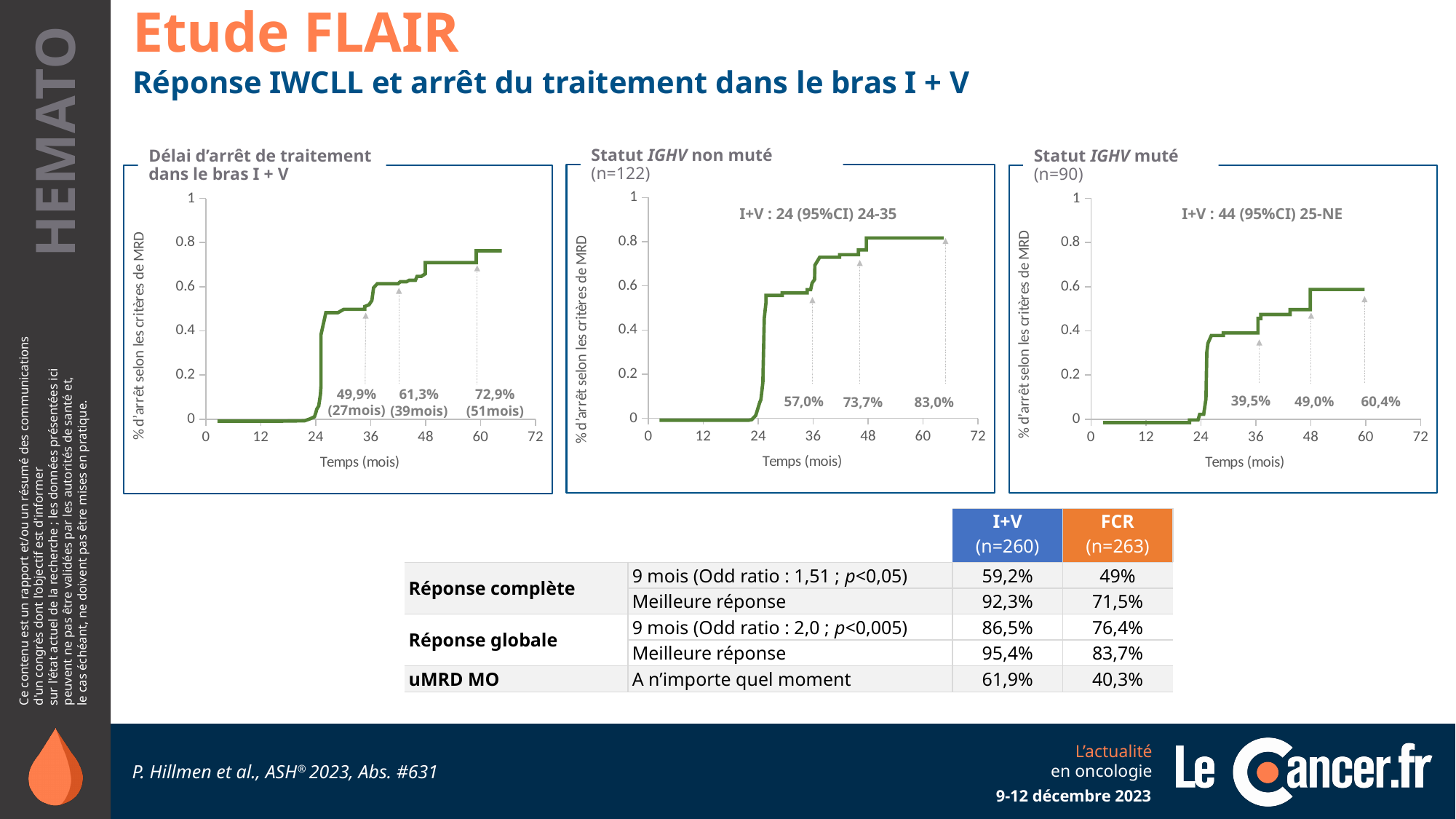
In the chart 'Délai d'arrêt de traitement dans le bras I + V', what is the difference between the values at 39 months and 27 months? 11,4% In the chart 'Statut IGHV non muté', what is the highest labelled percentage? 83,0% In the chart 'Statut IGHV muté', what is the lowest labelled percentage? 39,5% What is the sample size (n) given in the title of the 'Statut IGHV muté' chart? n=90 In the chart 'Statut IGHV muté', what is the difference between the highest and lowest labelled percentages? 20,9% In the chart 'Délai d'arrêt de traitement dans le bras I + V', what percentage is labelled at 51 months? 72,9% In the chart 'Statut IGHV muté', does the curve rise or fall as time increases? rise What kind of chart is the 'Statut IGHV non muté' chart? line chart (step curve) How many charts are shown on the slide? 3 In the chart 'Délai d'arrêt de traitement dans le bras I + V', what percentage is labelled at 27 months? 49,9% In the chart 'Statut IGHV non muté', what is the second labelled percentage on the curve? 73,7% Which is larger: the last labelled percentage in the 'Statut IGHV non muté' chart or the last labelled percentage in the 'Statut IGHV muté' chart? Statut IGHV non muté (83,0%)